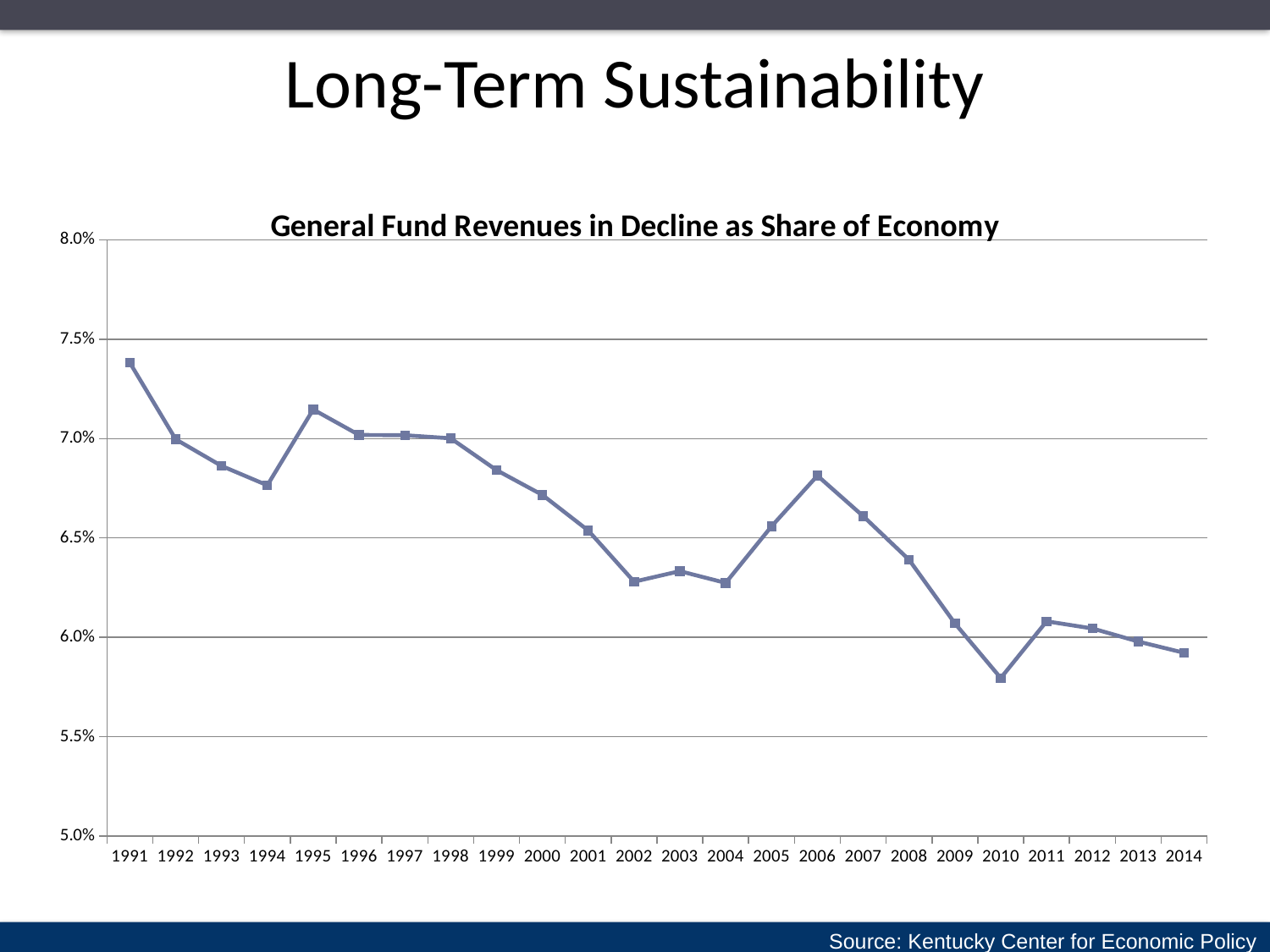
Which year has the larger value, 1995 or 1994? 1995 Is the value for 1991 greater or less than 7.0%? greater What kind of chart is shown on the slide? Line chart How many years are plotted on the x axis of the chart? 24 Is the value for 2006 greater or less than 6.5%? greater Is the value for 2002 greater or less than 6.5%? less Which year has the highest value in the chart? 1991 Which year has the lowest value in the chart? 2010 Overall, do the values rise or fall from 1991 to 2014? Fall What is the title of the chart? General Fund Revenues in Decline as Share of Economy